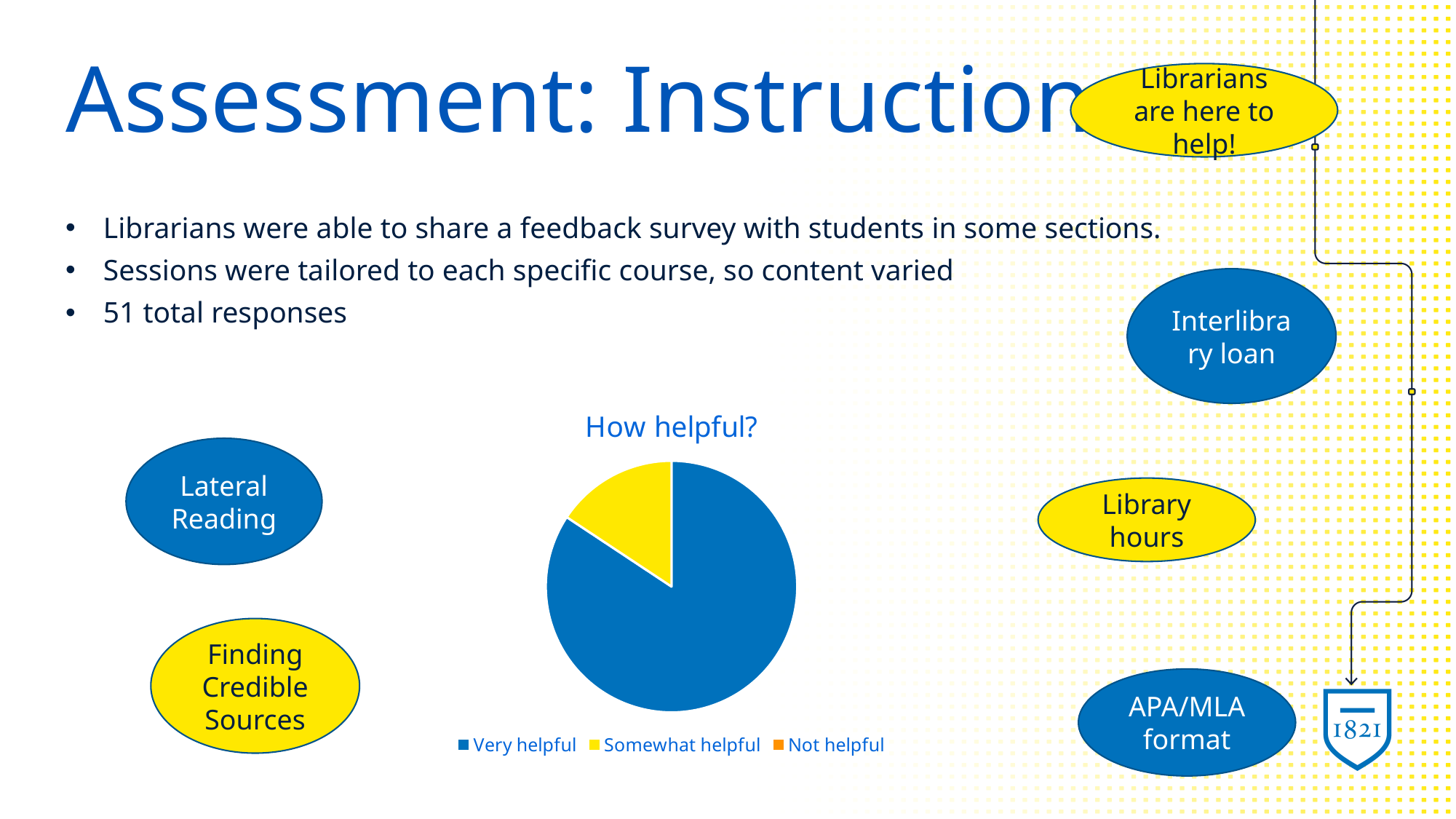
Which colour represents Somewhat helpful in the pie chart? yellow Which legend category has no visible slice in the pie chart? Not helpful Which slice is larger in the pie chart, Very helpful or Somewhat helpful? Very helpful What kind of chart is shown on the slide? pie chart What is the title of the pie chart? How helpful? Which category has the largest slice in the pie chart? Very helpful Does the Very helpful slice take up more or less than half of the pie chart? more How many entries does the legend of the pie chart list? 3